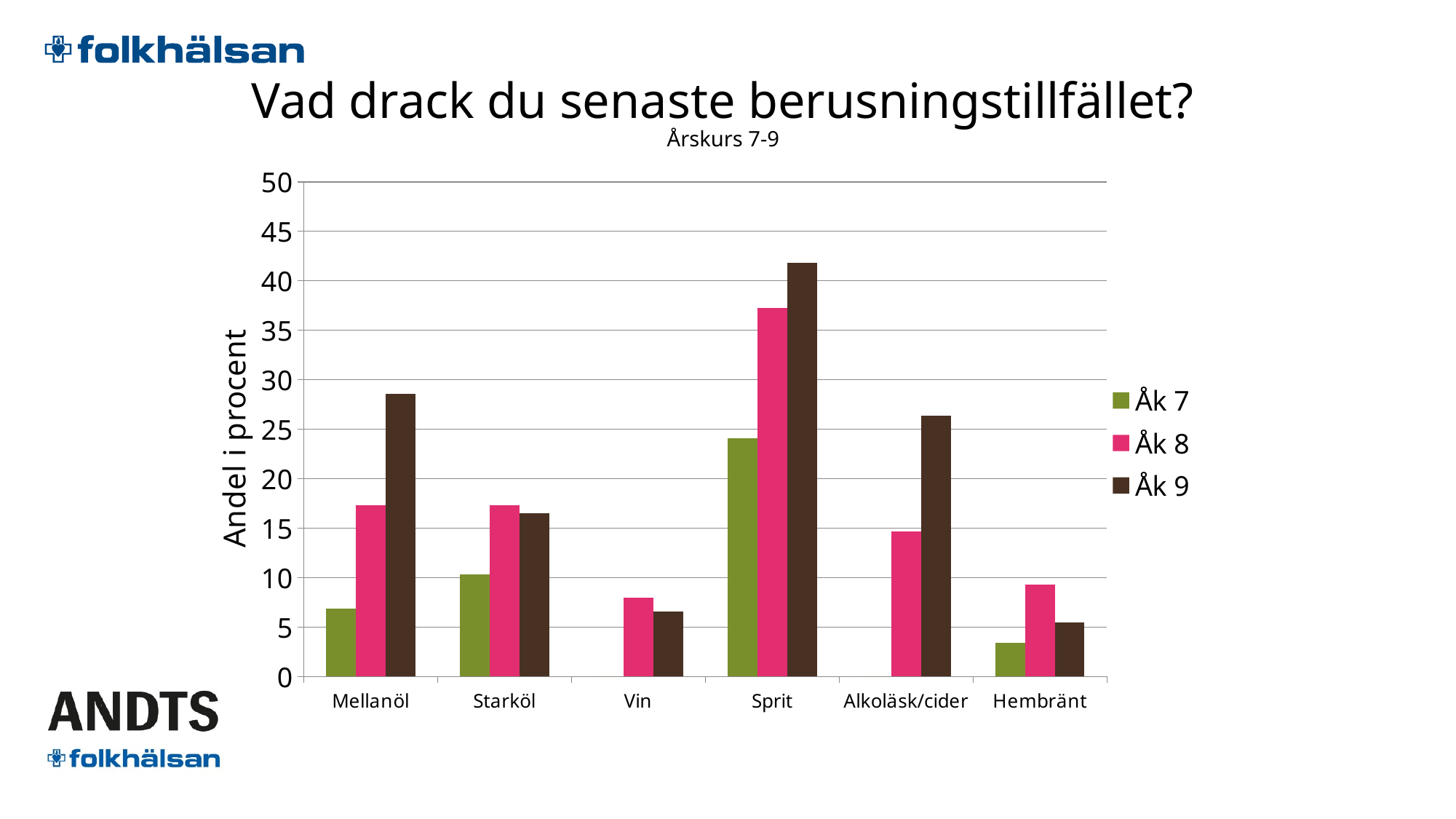
How many series does the legend list? 3 How many categories are shown on the x axis? 6 What is the title of the y axis? Andel i procent Is the value for Åk 7 in Mellanöl greater or less than 10? less Is the value for Åk 9 in Alkoläsk/cider greater or less than 25? greater For Mellanöl, which series has the larger value, Åk 8 or Åk 9? Åk 9 Which category has the highest value for Åk 8? Sprit For Hembränt, which series has the larger value, Åk 8 or Åk 9? Åk 8 Which category has the highest value for Åk 9? Sprit Is the value for Åk 9 in Sprit greater or less than 40? greater What kind of chart is shown on the slide? Bar chart